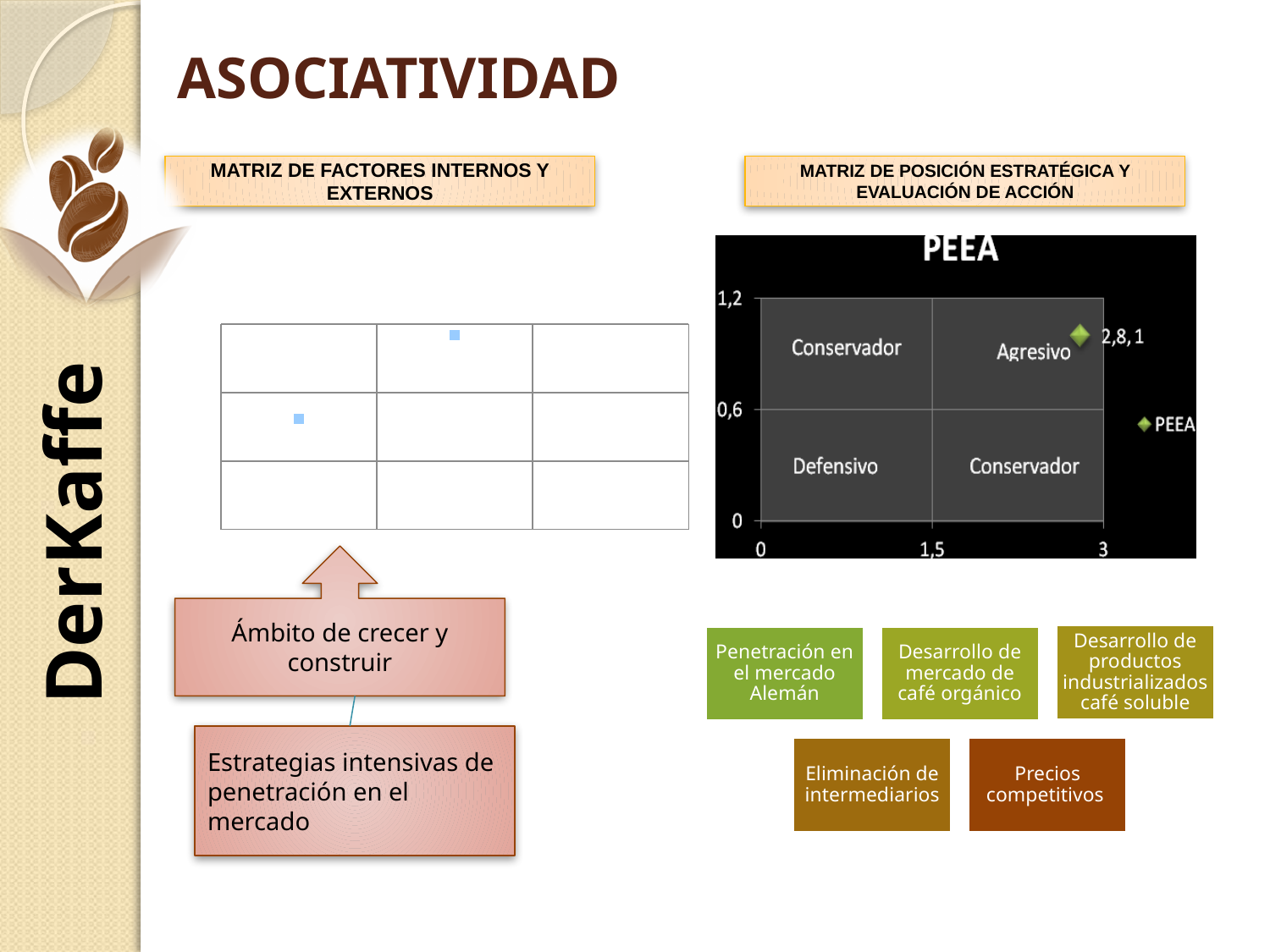
What kind of chart is the PEEA chart? scatter chart What is the name of the series shown in the legend of the PEEA chart? PEEA What is the highest tick value shown on the y axis of the PEEA chart? 1,2 What is the title of the chart on the right side of the slide? PEEA On the PEEA chart, is the y value of the plotted point greater or less than 0,6? greater What label is written in the bottom-left quadrant of the PEEA chart? Defensivo How many series does the legend of the PEEA chart list? 1 What is the data label printed next to the plotted point on the PEEA chart? 2,8, 1 How many data points are plotted on the PEEA chart? 1 On the PEEA chart, is the x value of the plotted point greater or less than 1,5? greater What is the highest tick value shown on the x axis of the PEEA chart? 3 In which quadrant of the PEEA chart does the plotted point fall? Agresivo